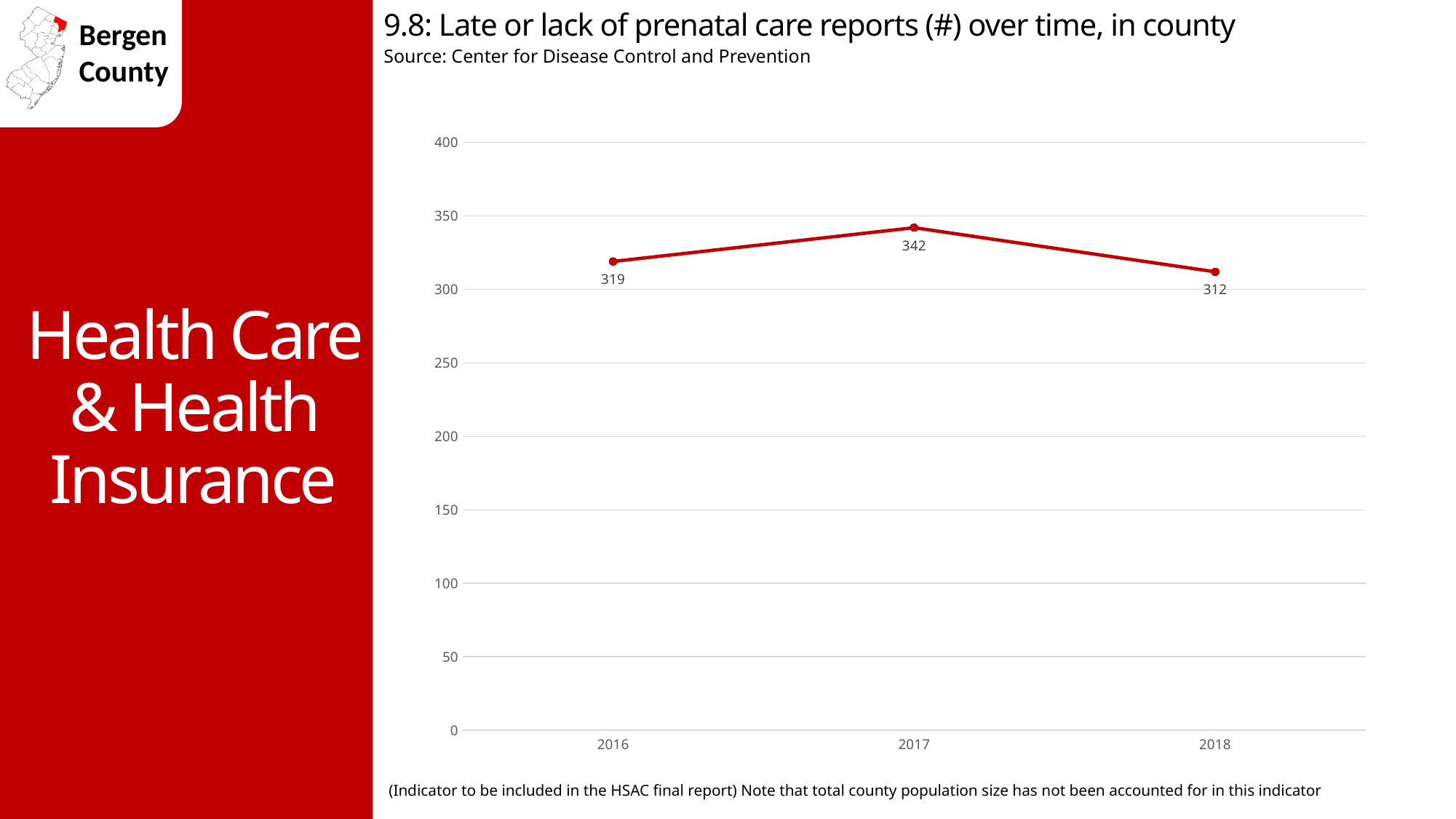
How many years are plotted on the chart? 3 What is the number of late or lack of prenatal care reports in 2016? 319 Which year has more late or lack of prenatal care reports, 2016 or 2018? 2016 Is the value for 2017 greater or less than 300? greater What is the difference between the number of reports in 2017 and 2016? 23 Which year has the lowest number of late or lack of prenatal care reports? 2018 What is the source of the data shown in the chart? Center for Disease Control and Prevention What is the number of late or lack of prenatal care reports in 2017? 342 Which year has the highest number of late or lack of prenatal care reports? 2017 What is the number of late or lack of prenatal care reports in 2018? 312 What kind of chart is shown on the slide? Line chart What is the difference between the number of reports in 2017 and 2018? 30